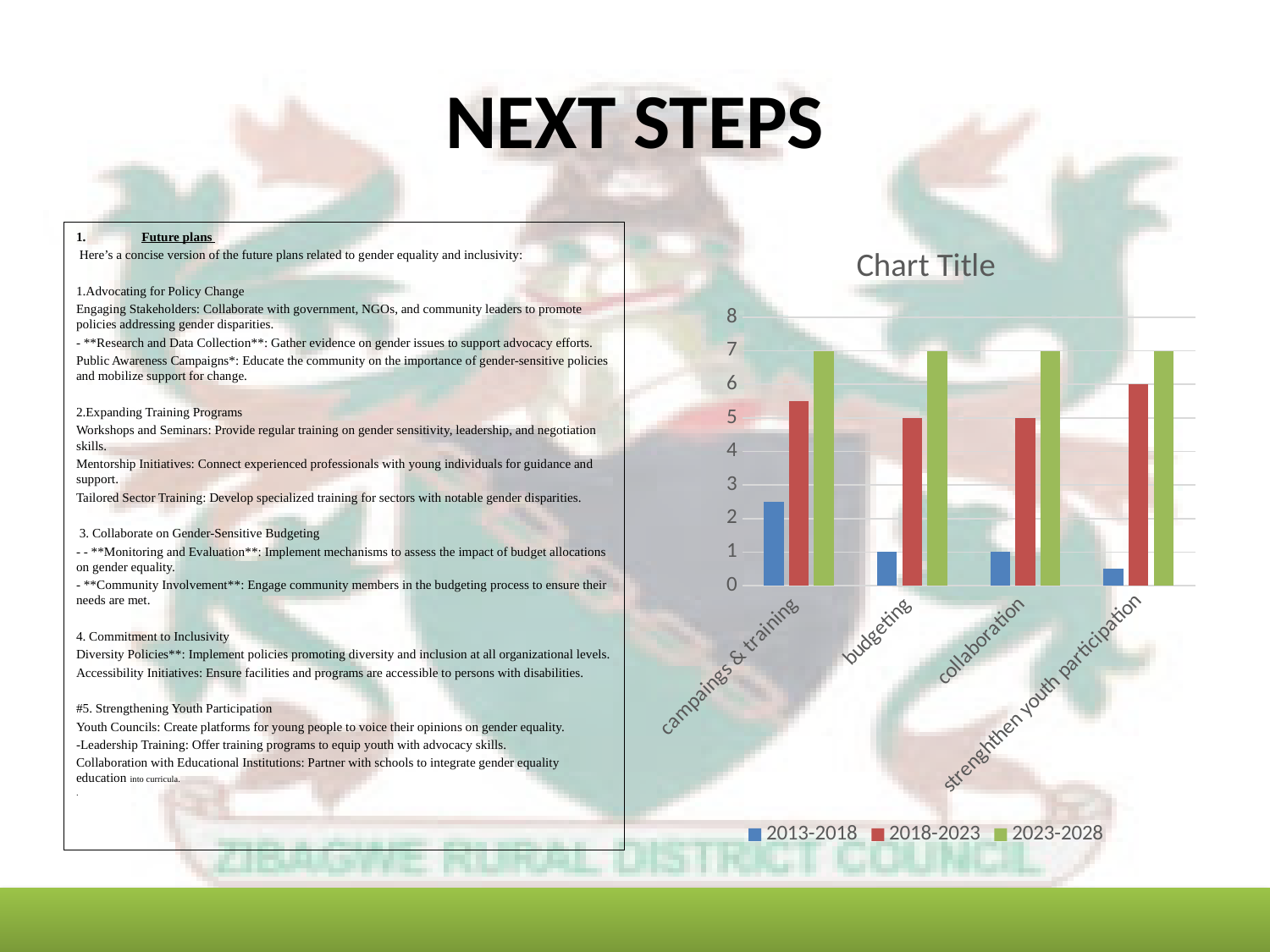
What is the value of the 2023-2028 bar for budgeting? 7 For collaboration, which is larger: the 2013-2018 value or the 2018-2023 value? 2018-2023 Which category has the highest 2013-2018 value? campaigns & training Is the 2018-2023 value for campaigns & training greater or less than 5? greater What is the value of the 2013-2018 bar for budgeting? 1 How many series does the chart's legend list? 3 Which category has the lowest 2013-2018 value? strengthen youth participation Is the 2013-2018 value for campaigns & training greater or less than 2? greater How many categories are shown on the x axis of the chart? 4 What are the three series named in the chart's legend? 2013-2018, 2018-2023, 2023-2028 What kind of chart is shown on the slide? bar chart What is the title shown above the chart? Chart Title